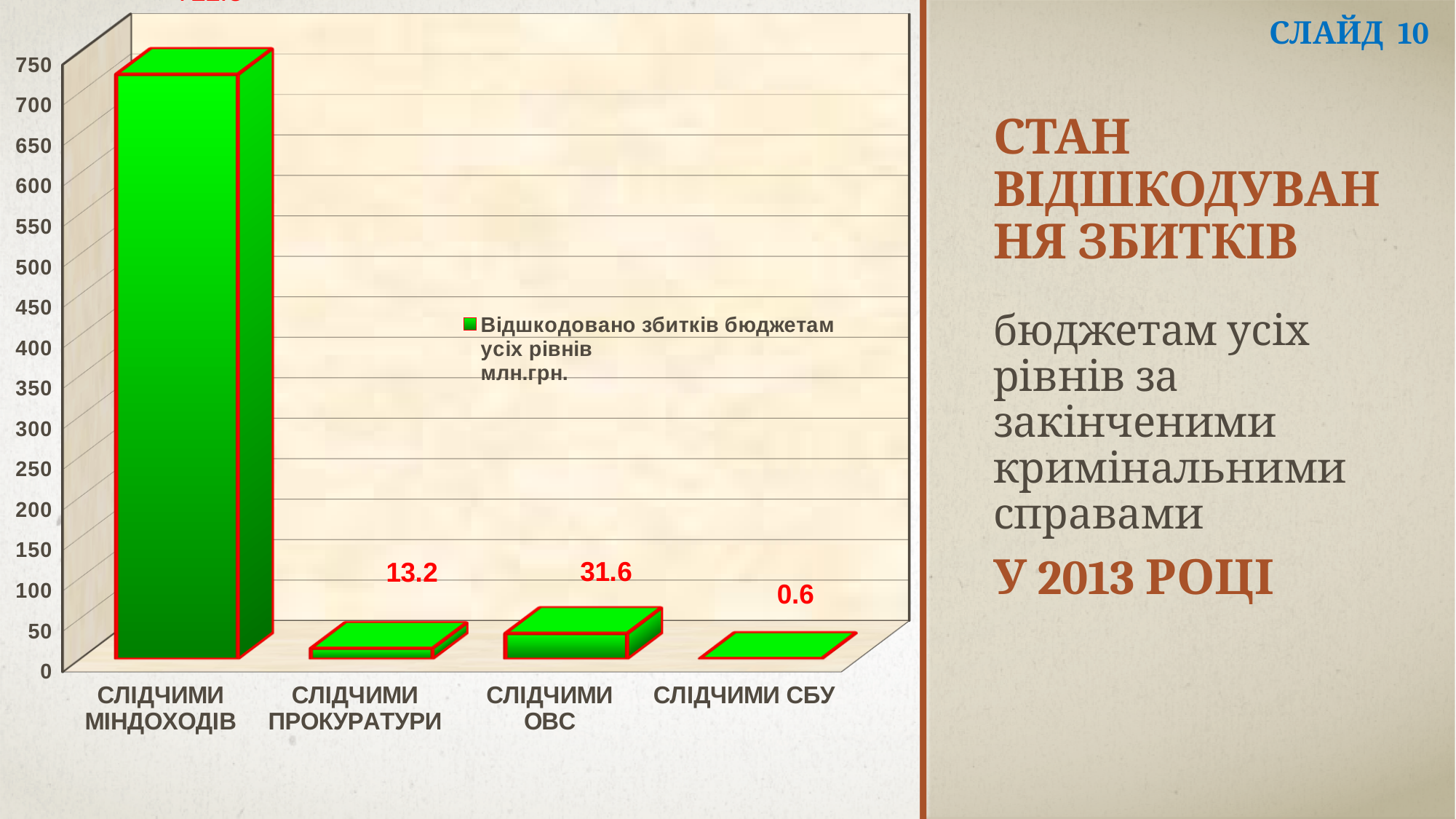
What value is shown for СЛІДЧИМИ ОВС? 31.6 What kind of chart is shown on the slide? bar chart What value is shown for СЛІДЧИМИ СБУ? 0.6 What is the difference between the values for СЛІДЧИМИ ПРОКУРАТУРИ and СЛІДЧИМИ СБУ? 12.6 What value is shown for СЛІДЧИМИ ПРОКУРАТУРИ? 13.2 What is the difference between the values for СЛІДЧИМИ ОВС and СЛІДЧИМИ ПРОКУРАТУРИ? 18.4 Which is larger, the value for СЛІДЧИМИ ОВС or for СЛІДЧИМИ ПРОКУРАТУРИ? СЛІДЧИМИ ОВС Is the value for СЛІДЧИМИ МІНДОХОДІВ greater or less than 700? greater How many series does the legend list? 1 How many categories are shown on the x axis? 4 Which category has the highest value? СЛІДЧИМИ МІНДОХОДІВ Which category has the lowest value? СЛІДЧИМИ СБУ